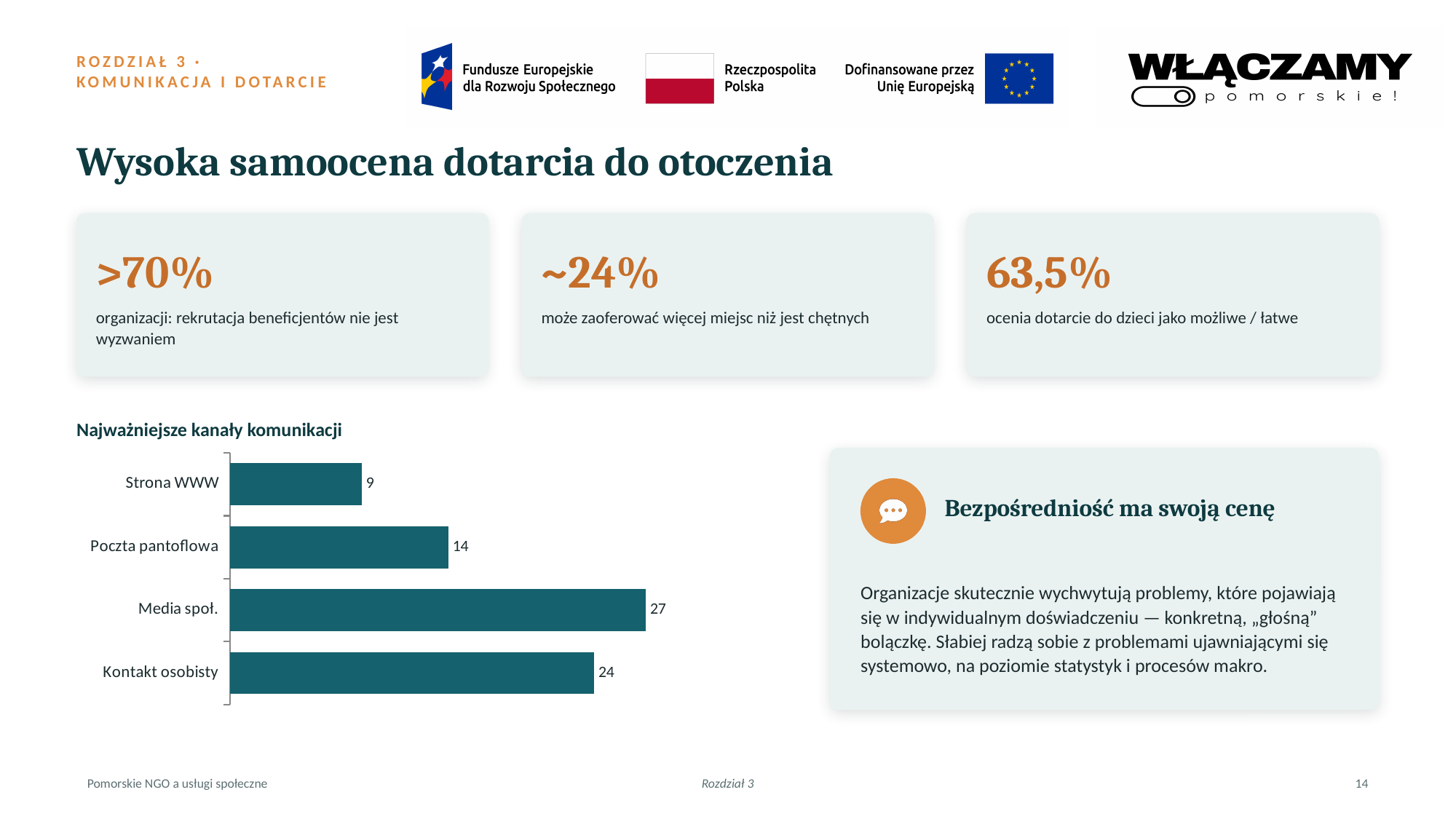
What is the value for Media społ. in the chart? 27 Which category has the highest value in the chart? Media społ. How many categories are shown in the chart? 4 What is the title of the chart? Najważniejsze kanały komunikacji Which category has the lowest value in the chart? Strona WWW What is the value for Strona WWW in the chart? 9 What is the difference between the values for Poczta pantoflowa and Strona WWW? 5 What is the value for Poczta pantoflowa in the chart? 14 What kind of chart is shown on the slide? Bar chart What is the difference between the values for Media społ. and Kontakt osobisty? 3 What is the value for Kontakt osobisty in the chart? 24 Which is larger, the value for Poczta pantoflowa or the value for Kontakt osobisty? Kontakt osobisty